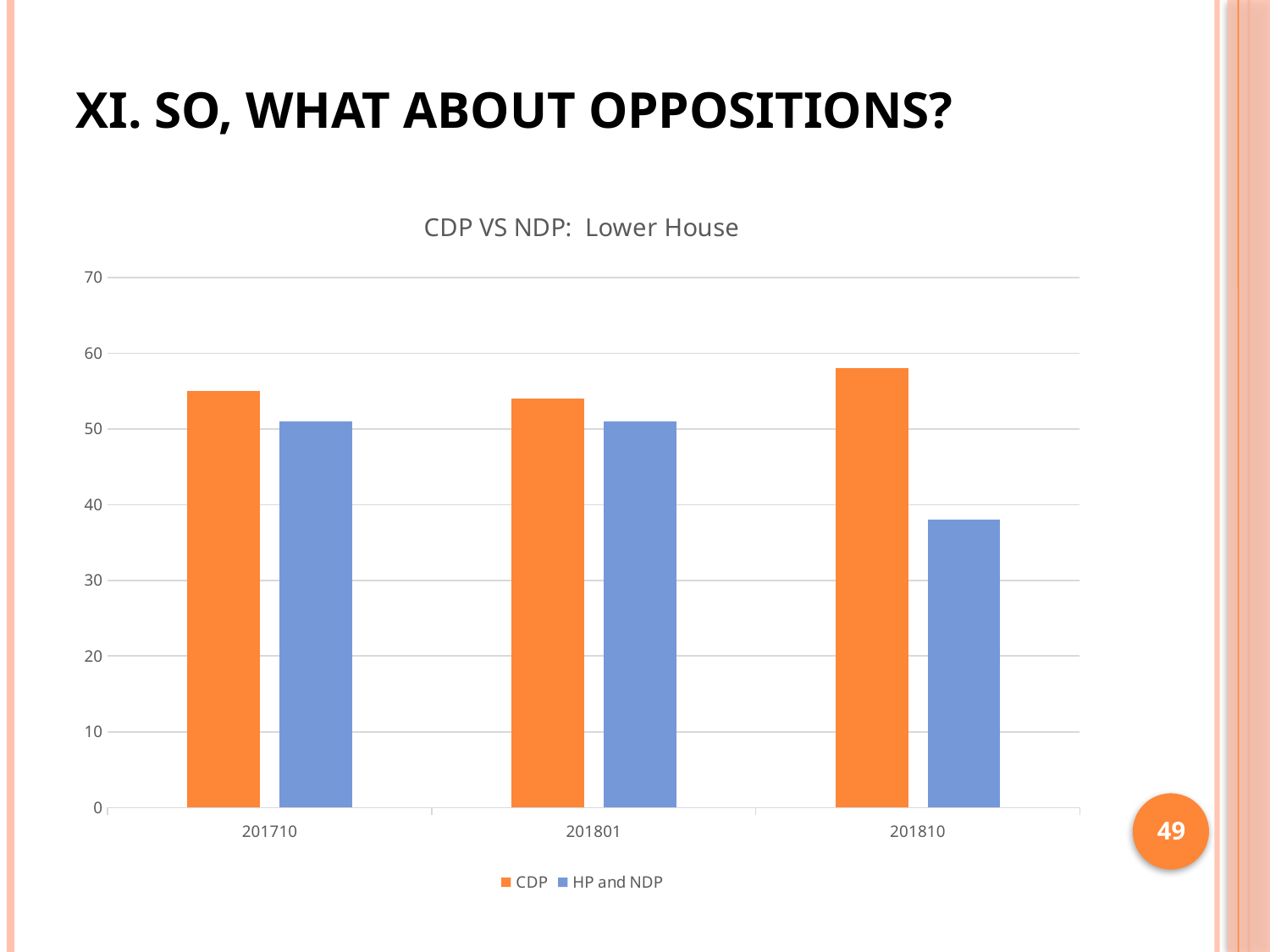
Is the value for CDP in 201810 greater or less than 50? greater Is the value for CDP in 201710 greater or less than 60? less In 201810, which series has the larger value, CDP or HP and NDP? CDP How many categories are shown on the x axis? 3 In which category is the HP and NDP value lowest? 201810 In which category is the CDP value highest? 201810 Is the value for HP and NDP in 201810 greater or less than 50? less What kind of chart is shown on the slide? bar chart Which series is shown in orange? CDP How many series does the legend list? 2 What is the title of the chart? CDP VS NDP: Lower House